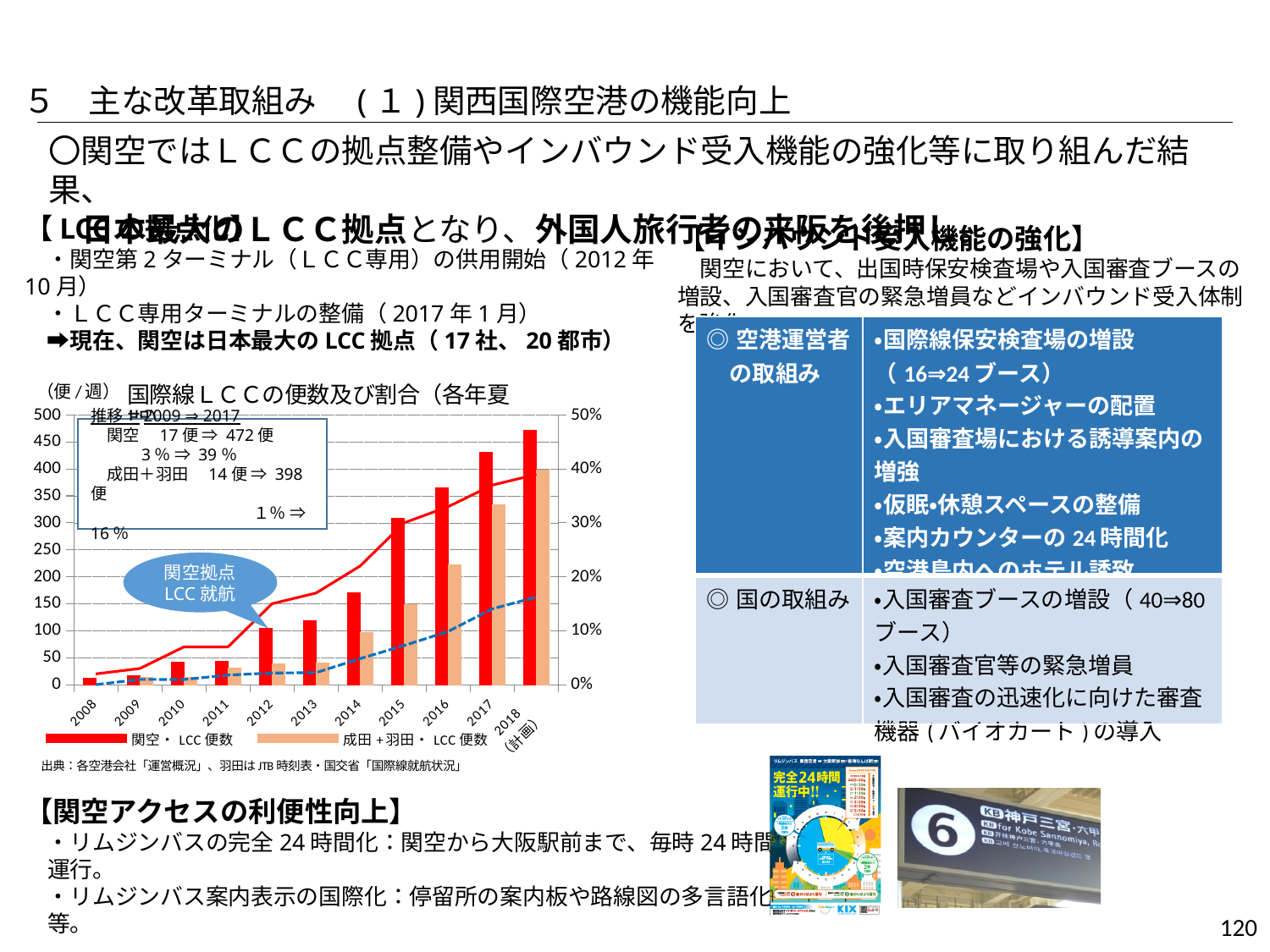
How many year categories are shown on the x axis of the chart? 11 How many series does the chart legend list? 2 Is the 関空・LCC便数 value for 2018（計画） greater or less than 400? greater According to the annotation on the chart, what was the 関空 LCC flight count in 2017? 472便 Is the 成田+羽田・LCC便数 value for 2017 greater or less than 300? greater What kind of chart is used to show the LCC flight numbers? Bar chart (with line series for the share) Do the 関空・LCC便数 bars generally rise or fall from 2008 to 2018（計画）? rise What is the title of the chart on the slide? 国際線ＬＣＣの便数及び割合（各年夏推移） In 2017, which is larger: 関空・LCC便数 or 成田+羽田・LCC便数? 関空・LCC便数 In which year is the 関空・LCC便数 bar the highest? 2018（計画） In which year is the 関空・LCC便数 bar the lowest? 2008 Is the 関空・LCC便数 value for 2012 greater or less than 150? less